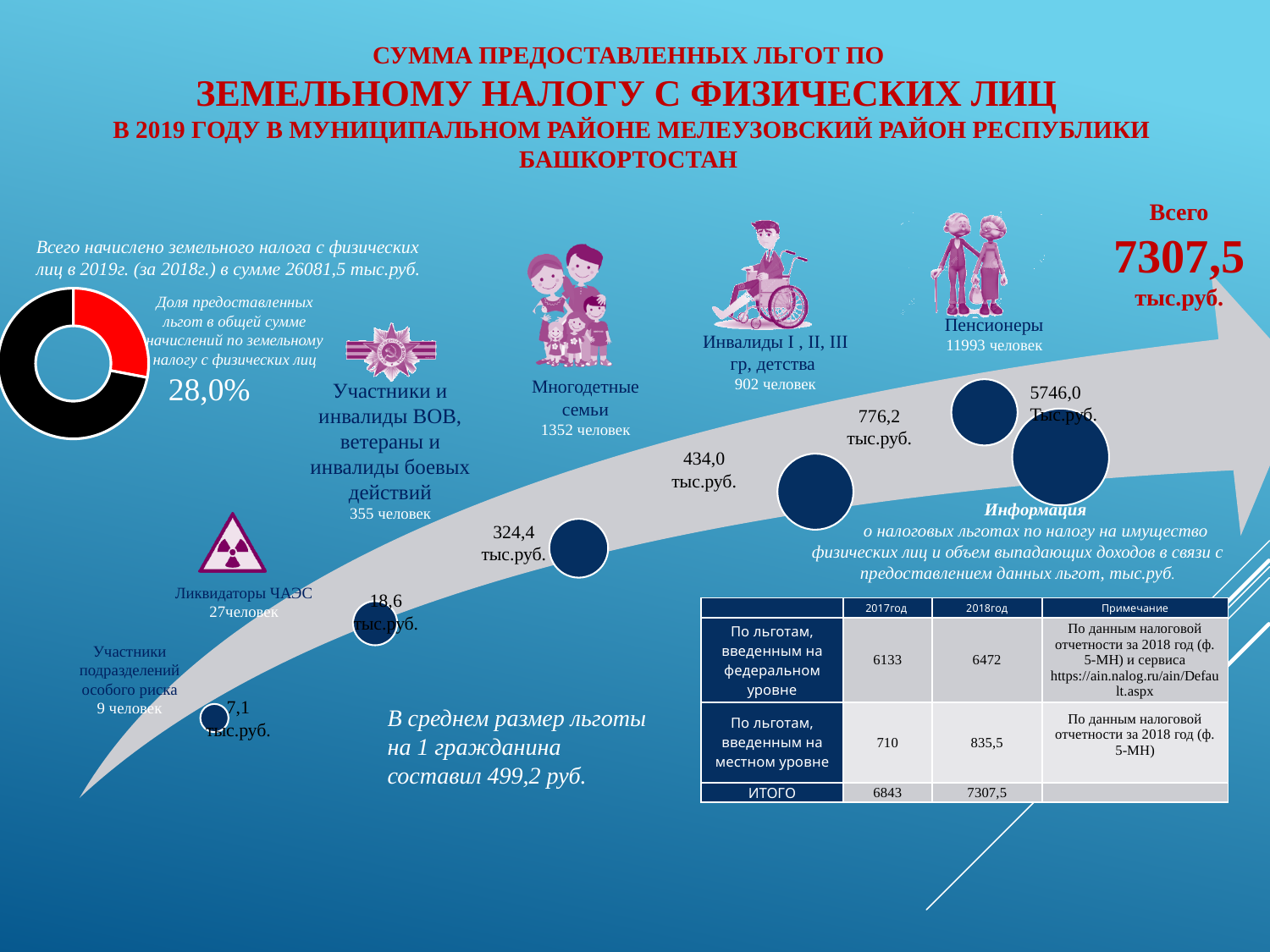
What share of total land tax accruals do the granted benefits represent, according to the donut chart? 28,0% Which slice of the donut chart is larger, the red one or the black one? The black one What colour is the slice of the donut chart that represents the 28,0% share of benefits? Red What kind of chart is shown on the left of the slide? Donut (pie) chart What does the donut chart represent, according to the caption next to it? Доля предоставленных льгот в общей сумме начислений по земельному налогу с физических лиц How many slices does the donut chart have? 2